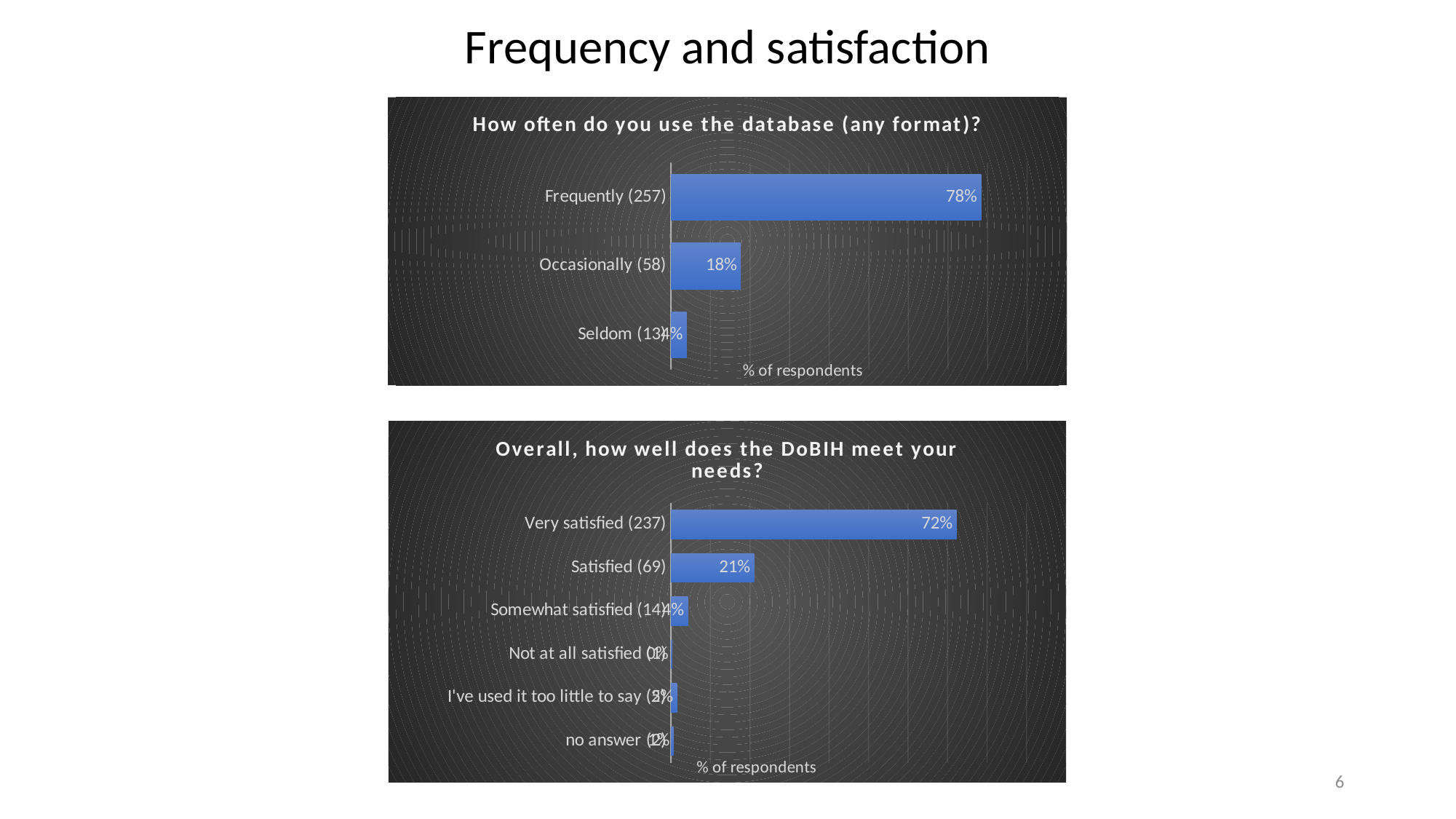
In the chart titled 'Overall, how well does the DoBIH meet your needs?', what percentage of respondents are Satisfied? 21% What type of chart is the top chart on the slide? Bar chart How many categories are shown in the chart titled 'How often do you use the database (any format)?' 3 In the chart titled 'Overall, how well does the DoBIH meet your needs?', which category has the highest percentage? Very satisfied (237) How many categories are shown in the chart titled 'Overall, how well does the DoBIH meet your needs?' 6 In the chart titled 'How often do you use the database (any format)?', which category has the highest percentage? Frequently (257) In the chart titled 'Overall, how well does the DoBIH meet your needs?', what percentage of respondents are Very satisfied? 72% In the chart titled 'How often do you use the database (any format)?', what percentage of respondents use the database Occasionally? 18% In the chart titled 'How often do you use the database (any format)?', what is the difference in percentage points between Frequently and Occasionally? 60 percentage points In the chart titled 'How often do you use the database (any format)?', what percentage of respondents use the database Frequently? 78% In the chart titled 'How often do you use the database (any format)?', which category has the lowest percentage? Seldom (13) In the chart titled 'Overall, how well does the DoBIH meet your needs?', which is larger: Satisfied or Somewhat satisfied? Satisfied